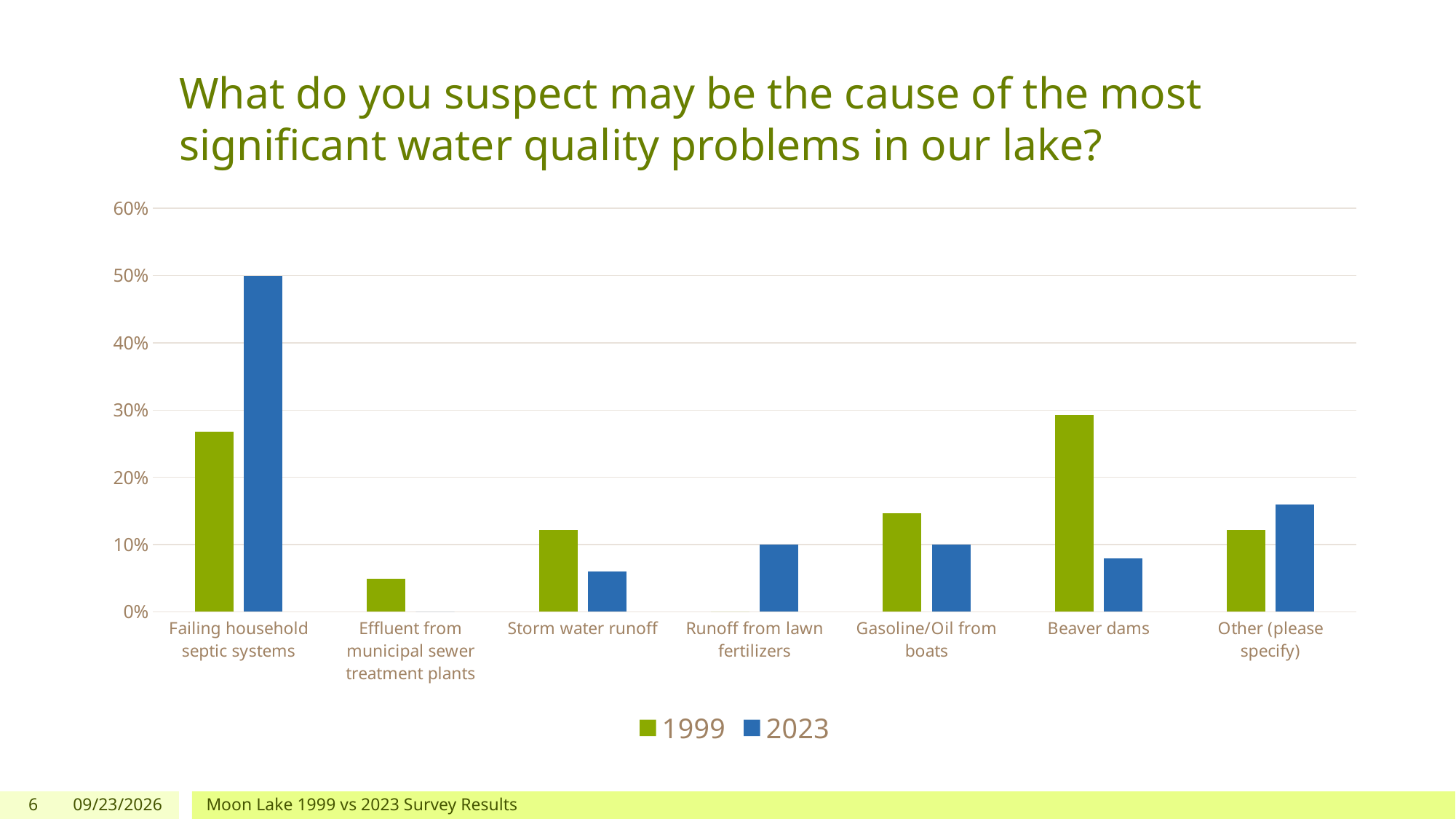
For Beaver dams, which series has the larger value, 1999 or 2023? 1999 What is the 2023 value for Failing household septic systems? 50% For Other (please specify), which series has the larger value, 1999 or 2023? 2023 Is the 1999 value for Beaver dams greater or less than 20%? greater Which series is shown in blue in the legend? 2023 Which category has the highest 2023 value? Failing household septic systems What kind of chart is shown on the slide? bar chart Which category has the highest 1999 value? Beaver dams Is the 2023 value for Storm water runoff greater or less than 10%? less How many categories are shown on the x axis? 7 How many series does the legend list? 2 What is the 2023 value for Runoff from lawn fertilizers? 10%